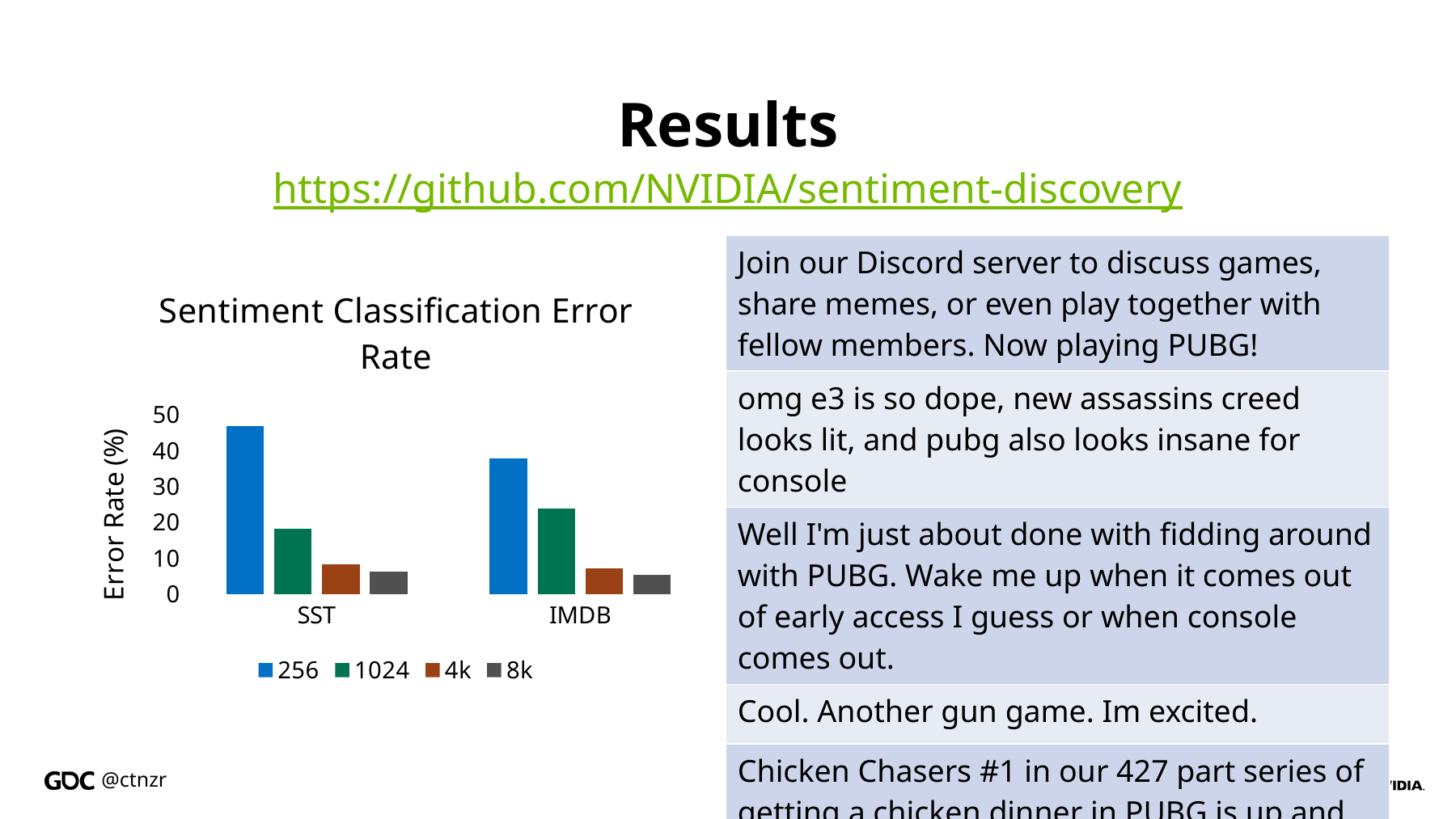
What kind of chart is shown on the slide? bar chart Within each category, do the error rates rise or fall as the series go from 256 to 8k? fall Which series has the highest error rate for SST? 256 Which series has the lowest error rate for IMDB? 8k Is the error rate for the 1024 series on IMDB greater or less than 20? greater Which is larger, the 256 error rate for SST or the 256 error rate for IMDB? SST What is the label of the vertical axis of the chart? Error Rate (%) How many categories are shown on the x axis of the chart? 2 How many series does the chart's legend list? 4 What is the title of the chart? Sentiment Classification Error Rate Is the error rate for the 4k series on SST greater or less than 10? less Is the error rate for the 256 series on SST greater or less than 40? greater